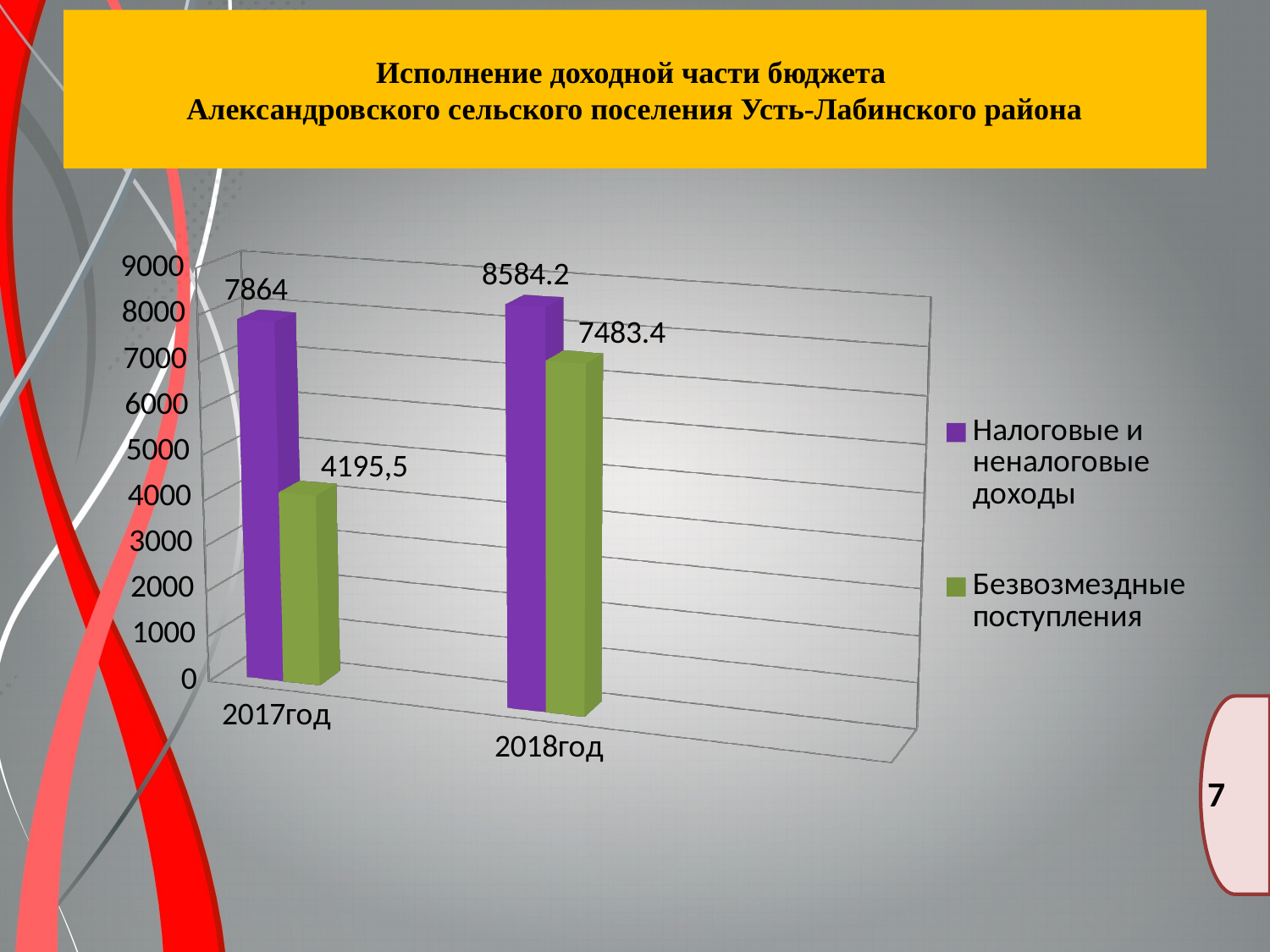
What is the value of Налоговые и неналоговые доходы for 2018год? 8584.2 What is the value of Безвозмездные поступления for 2018год? 7483.4 Which bar on the chart has the lowest value? Безвозмездные поступления, 2017год How many series does the legend list? 2 What is the difference between Налоговые и неналоговые доходы and Безвозмездные поступления in 2018год? 1100.8 By how much did Налоговые и неналоговые доходы increase from 2017год to 2018год? 720.2 What is the value of Безвозмездные поступления for 2017год? 4195,5 Which bar on the chart has the highest value? Налоговые и неналоговые доходы, 2018год Which is larger in 2017год: Налоговые и неналоговые доходы or Безвозмездные поступления? Налоговые и неналоговые доходы What kind of chart is shown on the slide? Bar chart What is the value of Налоговые и неналоговые доходы for 2017год? 7864 Do the values of Безвозмездные поступления rise or fall from 2017год to 2018год? Rise